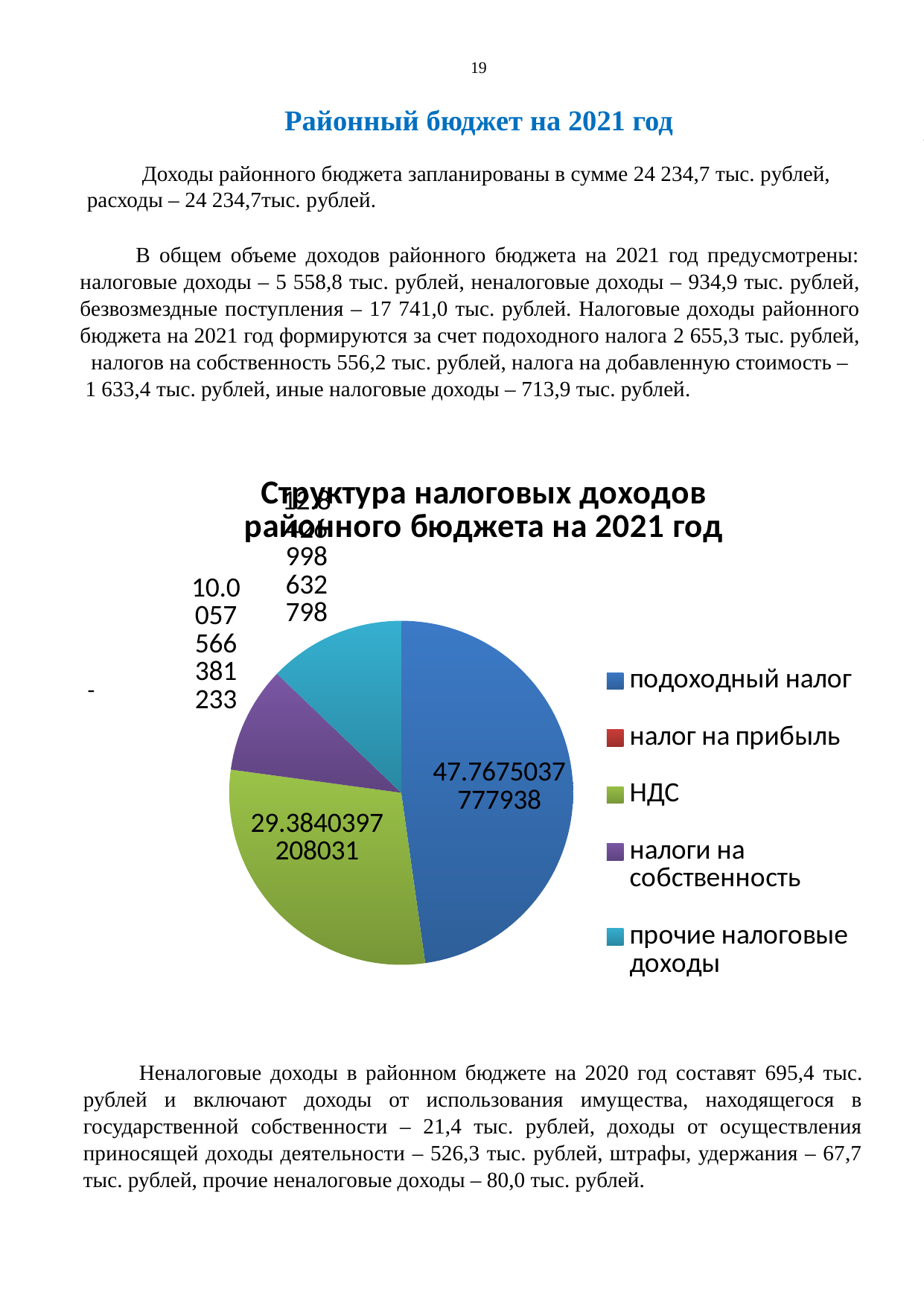
Which legend entry has no visible slice in the pie? налог на прибыль Which slice is larger, НДС or налоги на собственность? НДС What is the difference between the labelled values for подоходный налог and НДС? 18.3834640569907 Which category has the largest slice of the pie? подоходный налог How many entries does the chart legend list? 5 What value is labelled on the slice for подоходный налог? 47.7675037777938 What kind of chart is shown on the slide? pie chart What value is labelled on the slice for НДС? 29.3840397208031 What value is labelled on the slice for налоги на собственность? 10.0057566381233 What is the title of the chart? Структура налоговых доходов районного бюджета на 2021 год What colour is the slice for НДС? green